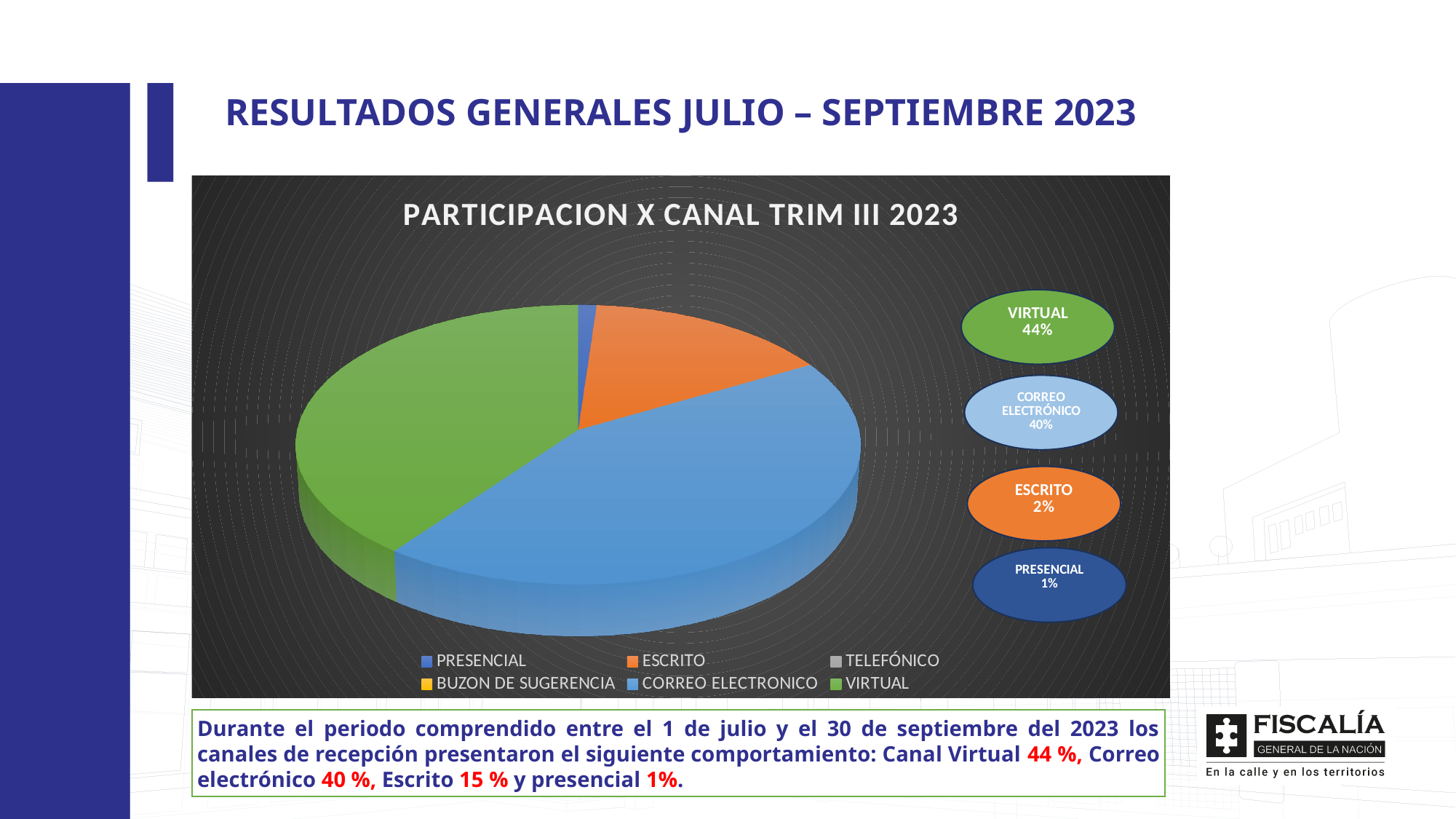
What share of the pie does VIRTUAL represent? 44% What share of the pie does CORREO ELECTRÓNICO represent? 40% What is the title of the chart? PARTICIPACION X CANAL TRIM III 2023 What kind of chart is shown on the slide? Pie chart Which has a larger share, CORREO ELECTRÓNICO or PRESENCIAL? CORREO ELECTRÓNICO Which has a larger share, VIRTUAL or CORREO ELECTRÓNICO? VIRTUAL What share of the pie does PRESENCIAL represent? 1% What is the difference in percentage points between the VIRTUAL share and the CORREO ELECTRÓNICO share? 4 percentage points What colour is the VIRTUAL slice of the pie? Green Which channel has the largest share of the pie? VIRTUAL What is the combined share of VIRTUAL and CORREO ELECTRÓNICO? 84% How many entries does the chart legend list? 6